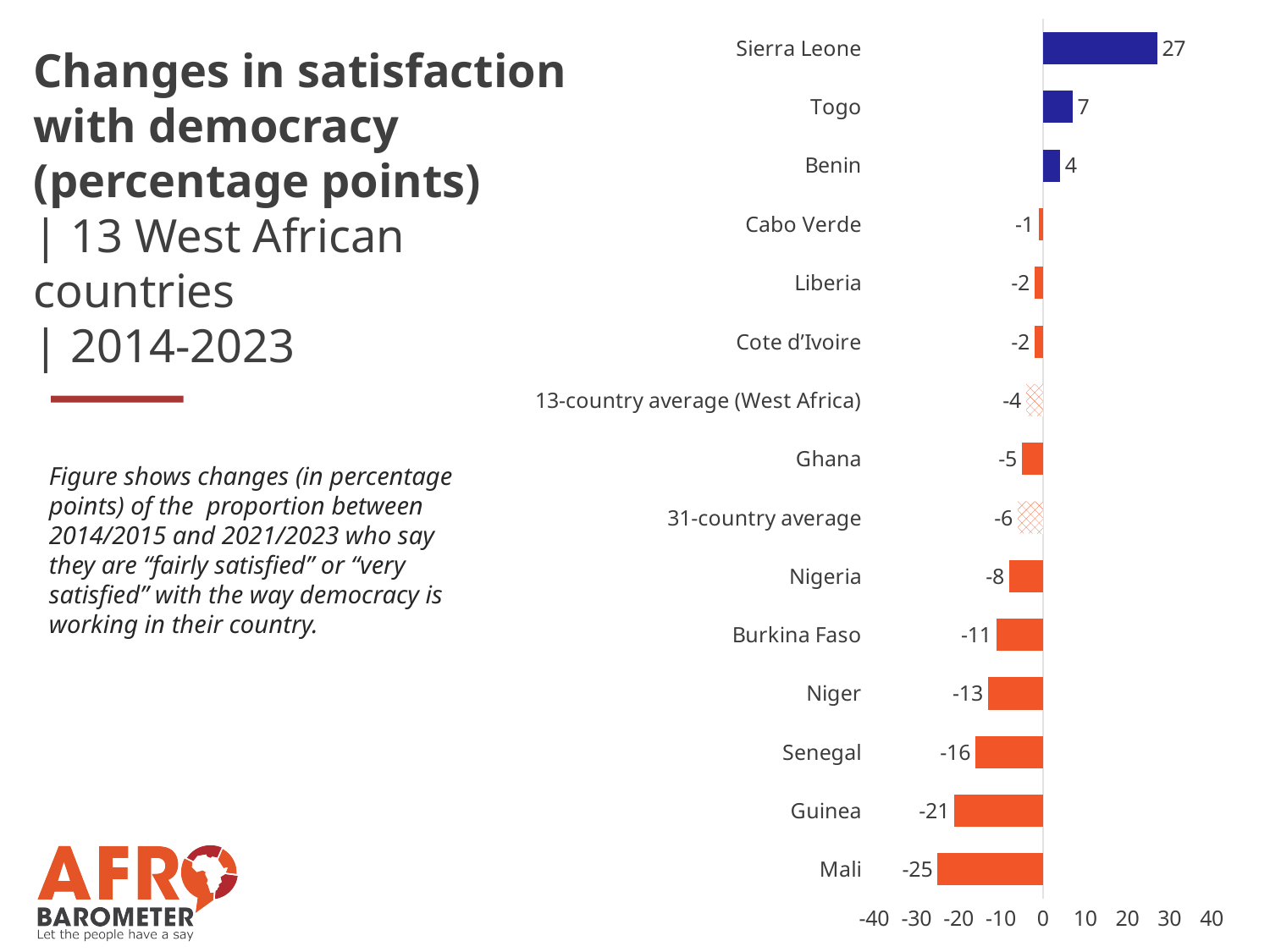
Which country has the lowest change in satisfaction with democracy? Mali What is the change in satisfaction with democracy for Sierra Leone? 27 What is the difference between the 31-country average and the 13-country average (West Africa)? 2 What kind of chart is shown on the slide? Bar chart What is the value shown for Mali? -25 What is the value shown for Nigeria? -8 What is the value shown for the 13-country average (West Africa)? -4 Which country has the highest change in satisfaction with democracy? Sierra Leone How many countries show a positive change in satisfaction with democracy? 3 How many bars are plotted in the chart, including the two averages? 15 What is the difference between the values for Sierra Leone and Togo? 20 Which has a larger value, Guinea or Senegal? Senegal